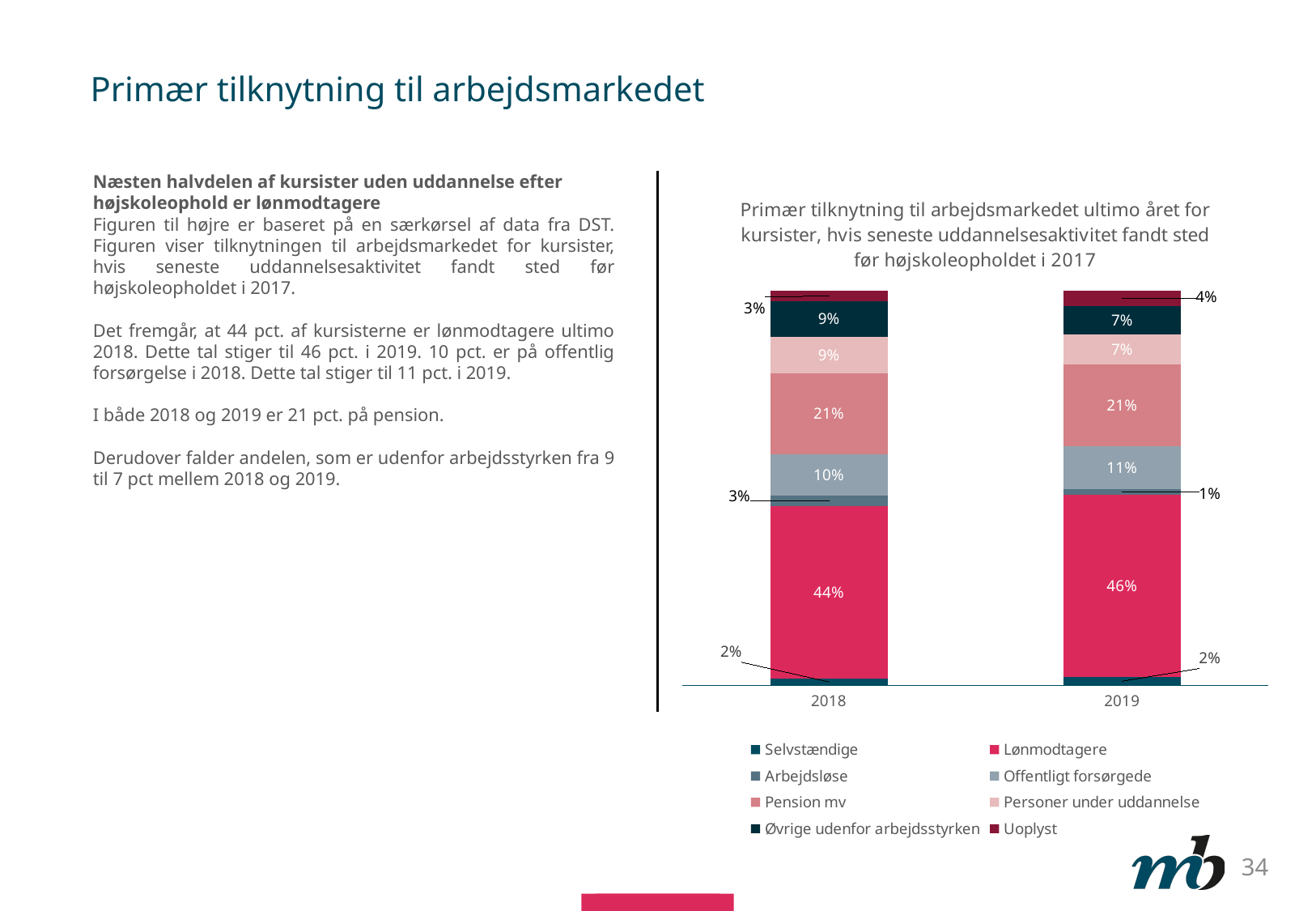
What is the difference between the Lønmodtagere values for 2019 and 2018? 2% How many series does the legend list? 8 What is the value for Lønmodtagere in 2019? 46% What is the value for Offentligt forsørgede in 2019? 11% Is the value for Øvrige udenfor arbejdsstyrken larger in 2018 or in 2019? 2018 Which series has the largest share in the 2019 bar? Lønmodtagere What is the value for Arbejdsløse in 2019? 1% What type of chart is shown on the slide? Stacked bar chart How many categories (years) are shown on the x axis? 2 What is the value for Lønmodtagere in 2018? 44% What is the value for Pension mv in 2018? 21% Does the value for Personer under uddannelse rise or fall from 2018 to 2019? Fall